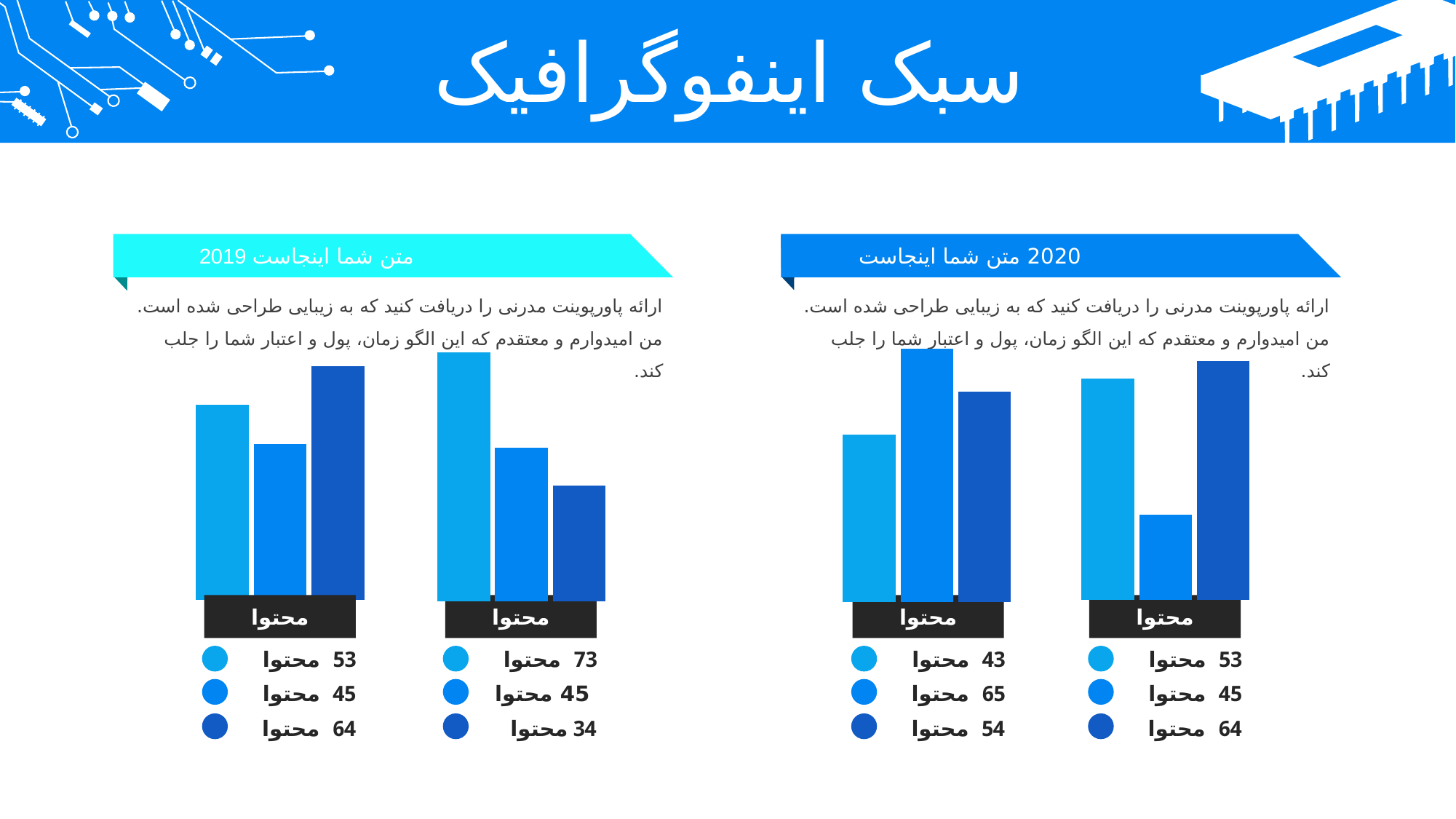
How many bars does each of the four small charts on the slide contain? 3 In the leftmost bar chart under the 2020 heading, what is the value of the medium blue bar? 65 In the leftmost bar chart under the 2019 heading, what is the value of the dark blue bar? 64 In the leftmost bar chart under the 2020 heading, which colour bar is the highest? medium blue (65) In the second bar chart from the left under the 2019 heading, which colour bar is the lowest? dark blue (34) What type of chart is used in the four small charts on the slide? bar chart In the leftmost bar chart under the 2019 heading, what is the value of the light blue bar? 53 In the second bar chart from the left under the 2019 heading, what is the value of the light blue bar? 73 How many entries does the legend below the rightmost chart under the 2020 heading list? 3 In the leftmost bar chart under the 2020 heading, is the light blue bar (43) or the dark blue bar (54) larger? dark blue (54) In the second bar chart from the left under the 2019 heading, what is the difference between the light blue bar (73) and the dark blue bar (34)? 39 In the rightmost bar chart under the 2020 heading, what is the value of the dark blue bar? 64